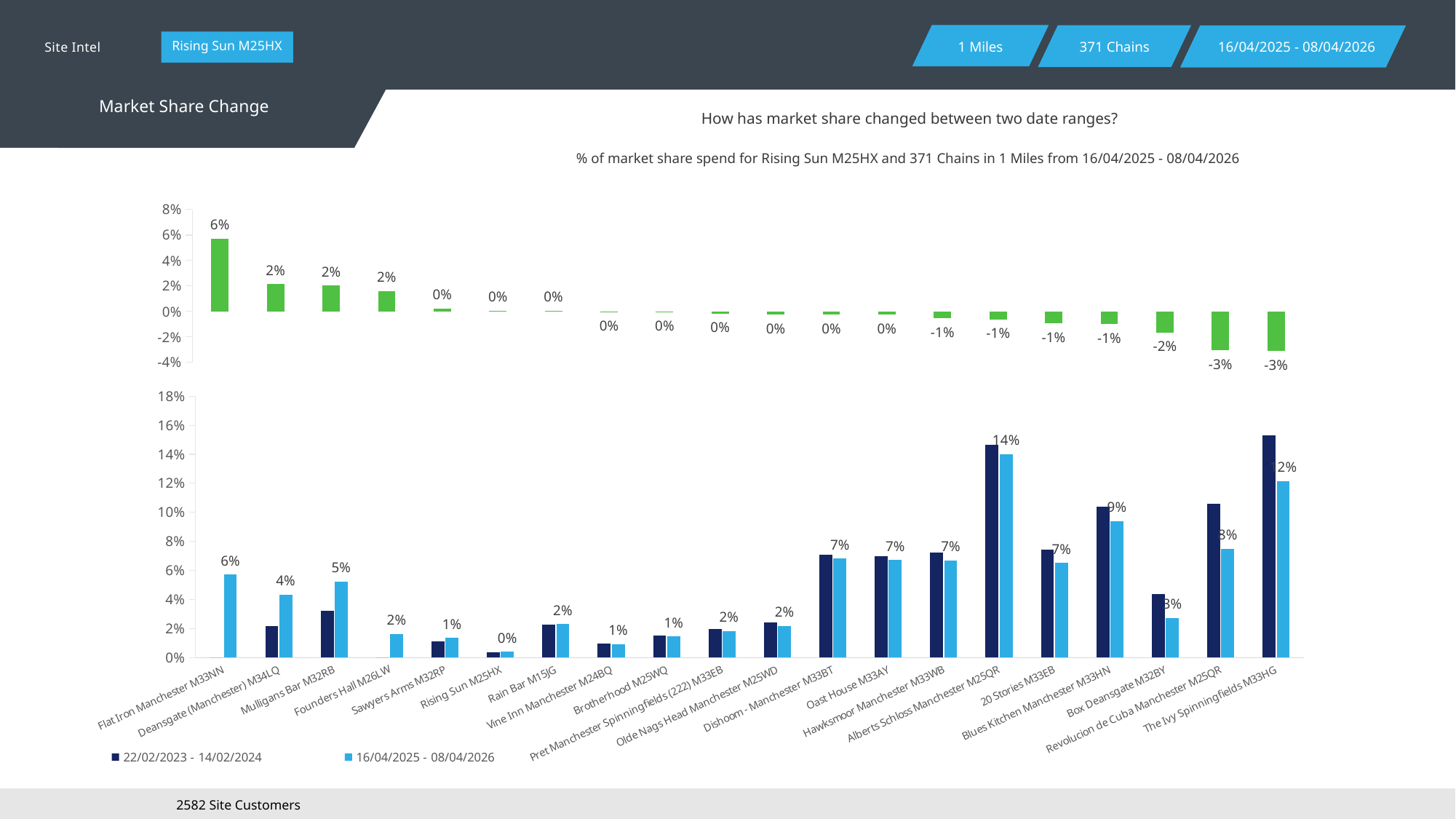
In the top chart (market share change), which category has the highest value? Flat Iron Manchester M33NN In the bottom chart, what is the value for Alberts Schloss Manchester M25QR in the 16/04/2025 - 08/04/2026 series? 14% In the top chart (market share change), what is the value for Flat Iron Manchester M33NN? 6% In the top chart (market share change), what is the value for Box Deansgate M32BY? -2% What kind of chart is the bottom chart? Bar chart In the bottom chart, is the value for The Ivy Spinningfields M33HG in the 22/02/2023 - 14/02/2024 series greater or less than 14%? greater In the bottom chart, what is the value for The Ivy Spinningfields M33HG in the 16/04/2025 - 08/04/2026 series? 12% How many categories are shown on the x axis of the bottom chart? 20 How many series does the legend of the bottom chart list? 2 In the top chart (market share change), what is the value for Revolucion de Cuba Manchester M25QR? -3% In the bottom chart, for the 16/04/2025 - 08/04/2026 series, which is larger: Alberts Schloss Manchester M25QR or The Ivy Spinningfields M33HG? Alberts Schloss Manchester M25QR In the bottom chart, what is the difference between Alberts Schloss Manchester M25QR and Blues Kitchen Manchester M33HN in the 16/04/2025 - 08/04/2026 series? 5%